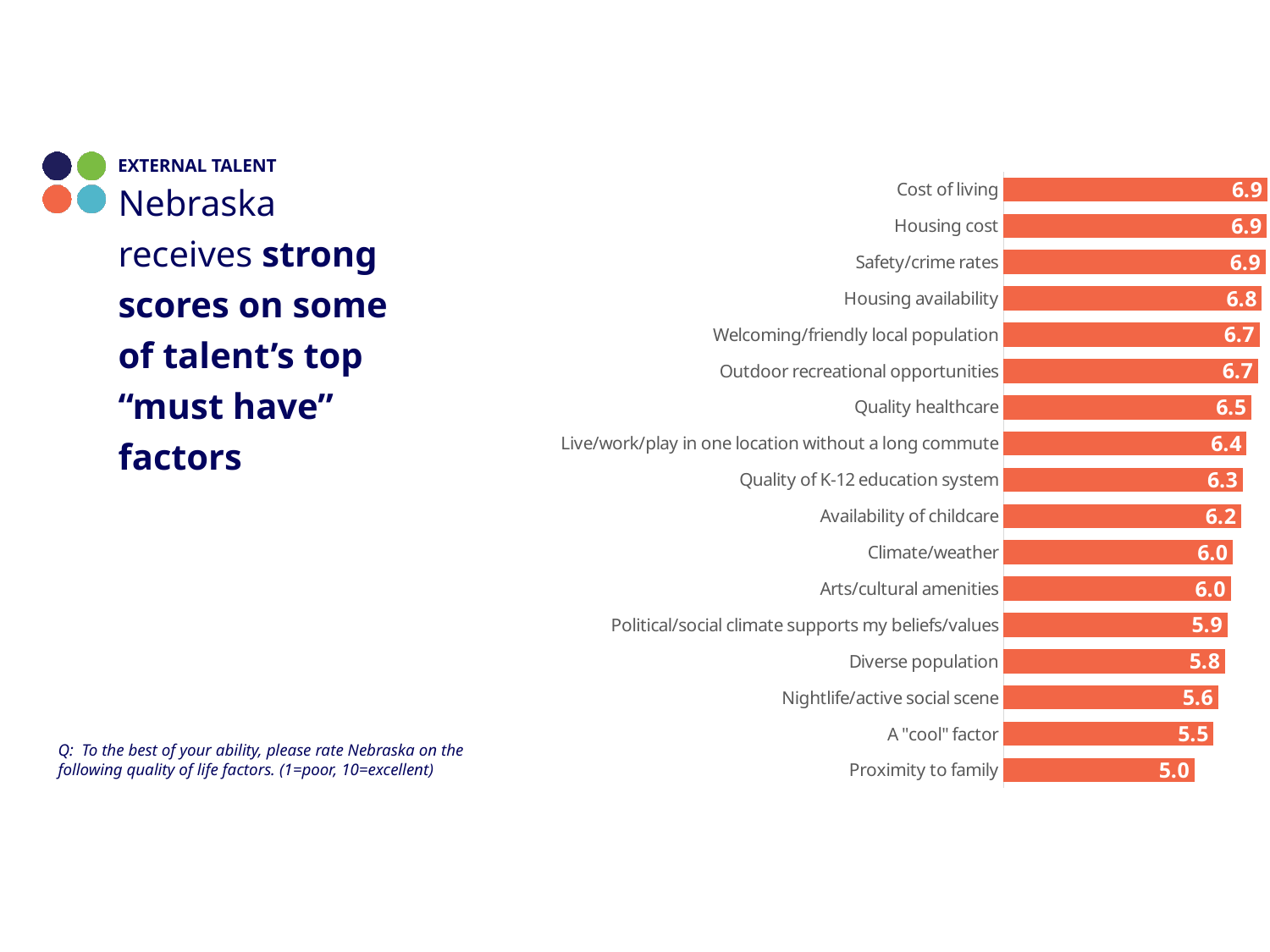
How many quality of life factors are shown in the chart? 17 What is the difference between the scores for Quality of K-12 education system and Diverse population? 0.5 What is the score for Quality healthcare? 6.5 What type of chart is shown on the slide? Bar chart What score does Nebraska receive for Cost of living? 6.9 Which factor has the lowest score? Proximity to family What is the score for Availability of childcare? 6.2 Which has a higher score, Welcoming/friendly local population or Political/social climate supports my beliefs/values? Welcoming/friendly local population How many factors share the top score of 6.9? 3 Which has a higher score, Climate/weather or Nightlife/active social scene? Climate/weather What is the difference between the scores for Housing availability and A "cool" factor? 1.3 What is the score for Proximity to family? 5.0